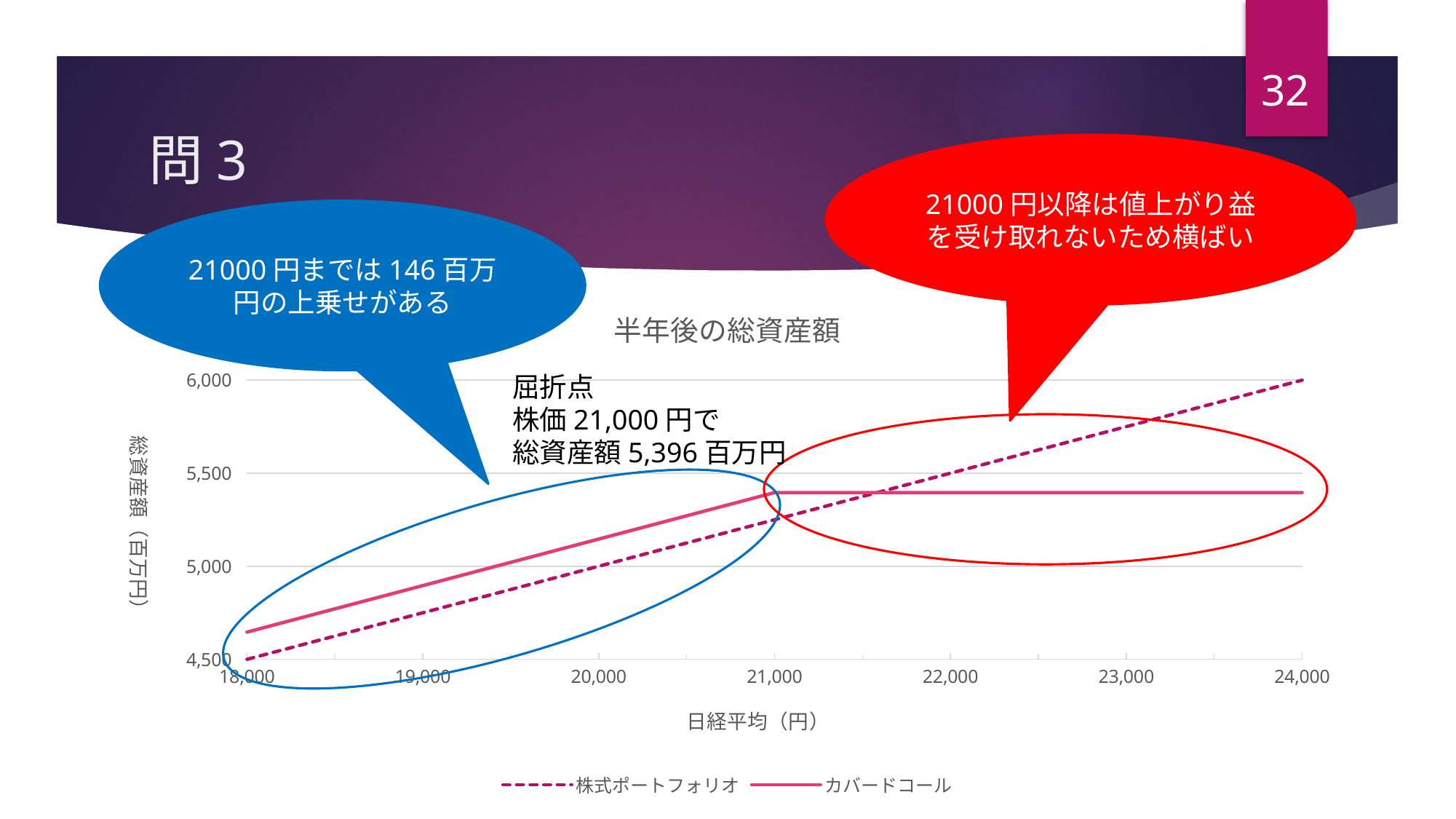
What is the label of the x axis? 日経平均（円） At a 日経平均 of 23,000, which series has the higher total asset value, 株式ポートフォリオ or カバードコール? 株式ポートフォリオ How many series does the legend list? 2 Is the value of the カバードコール series at a 日経平均 of 18,000 greater or less than 5,000? less How does the カバードコール line behave as the 日経平均 rises from 21,000 to 24,000? flat (横ばい) According to the annotation, what is the total asset value (総資産額) of the カバードコール series at a stock price of 21,000円? 5,396百万円 At a 日経平均 of 19,000, which series has the higher total asset value, 株式ポートフォリオ or カバードコール? カバードコール Is the value of the 株式ポートフォリオ series at a 日経平均 of 23,000 greater or less than 5,500? greater What kind of chart is shown on the slide? line chart At what 日経平均 value does the 屈折点 (kink point) of the カバードコール line occur? 21,000円 What is the title of the chart? 半年後の総資産額 Does the 株式ポートフォリオ line rise or fall as the 日経平均 increases from 18,000 to 24,000? rises